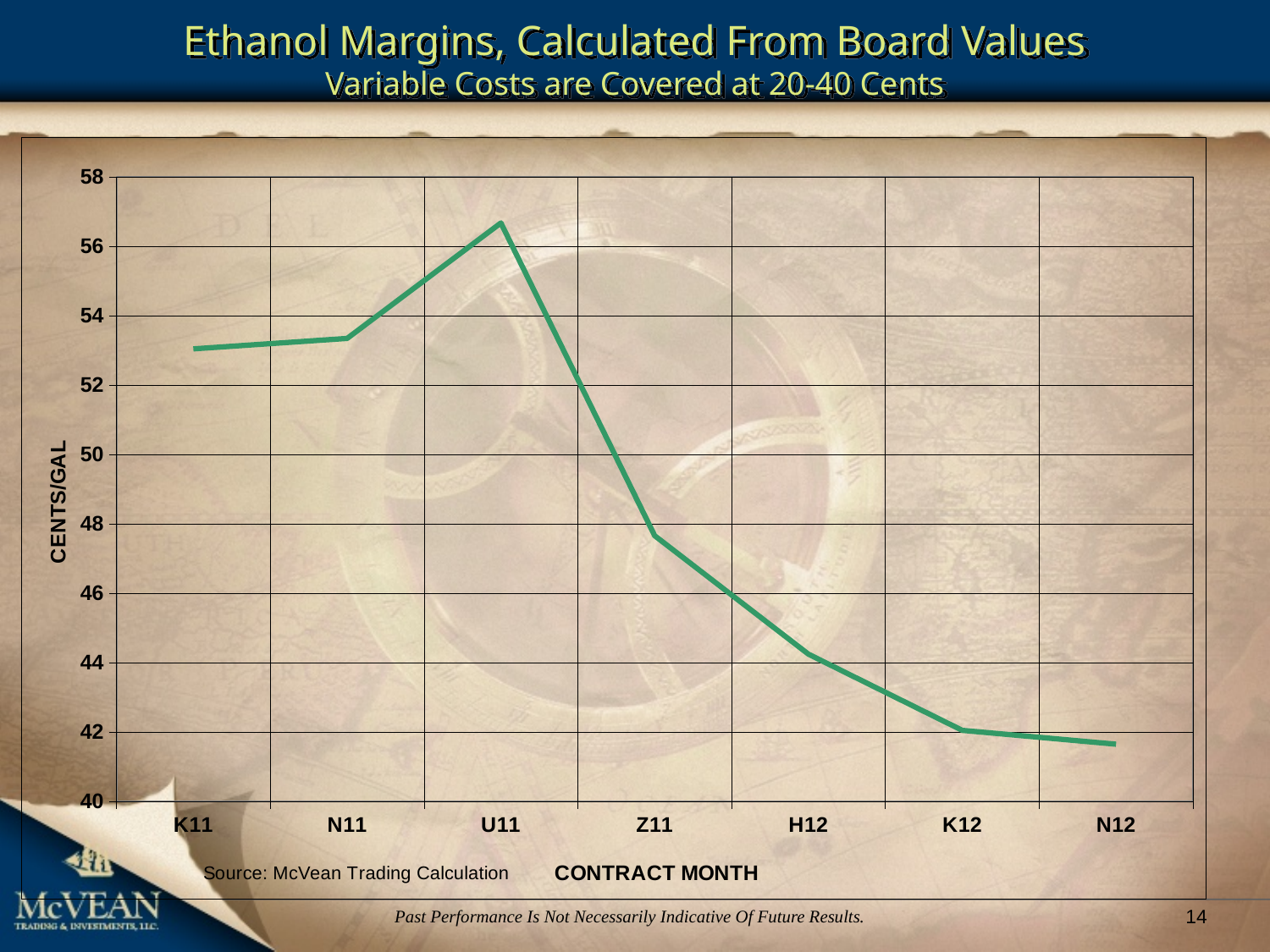
Is the value for U11 greater or less than 56? greater What is the label on the y axis? CENTS/GAL Is the value for N12 greater or less than 44? less Do the values rise or fall from U11 to N12? fall Which has the larger margin, U11 or Z11? U11 What kind of chart is shown on the slide? line chart Is the value for K11 greater or less than 52? greater Which contract month has the highest ethanol margin? U11 How many contract months are plotted on the x axis? 7 Which contract month has the lowest ethanol margin? N12